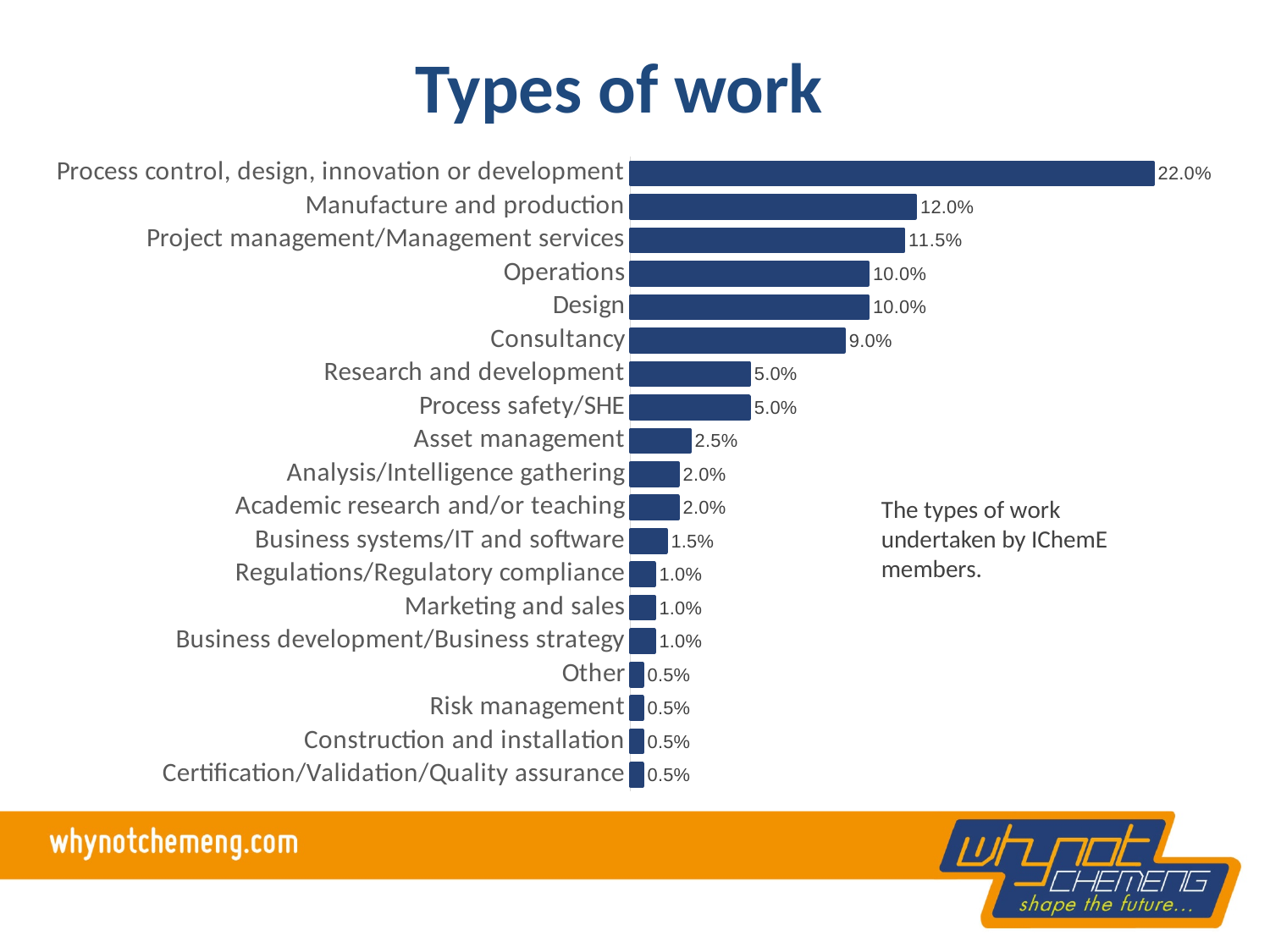
How many types of work are shown in the chart? 19 What is the value for Asset management? 2.5% What value is shown for Risk management? 0.5% What type of chart is shown on the slide? bar chart Which type of work has the highest value? Process control, design, innovation or development What is the value for Process control, design, innovation or development? 22.0% What is the title of the slide? Types of work What is the difference between the values for Consultancy and Research and development? 4.0% What is the difference between the values for Process control, design, innovation or development and Manufacture and production? 10.0% What is the value for Consultancy? 9.0% Which is larger, the value for Manufacture and production or the value for Project management/Management services? Manufacture and production What is the value for Business systems/IT and software? 1.5%